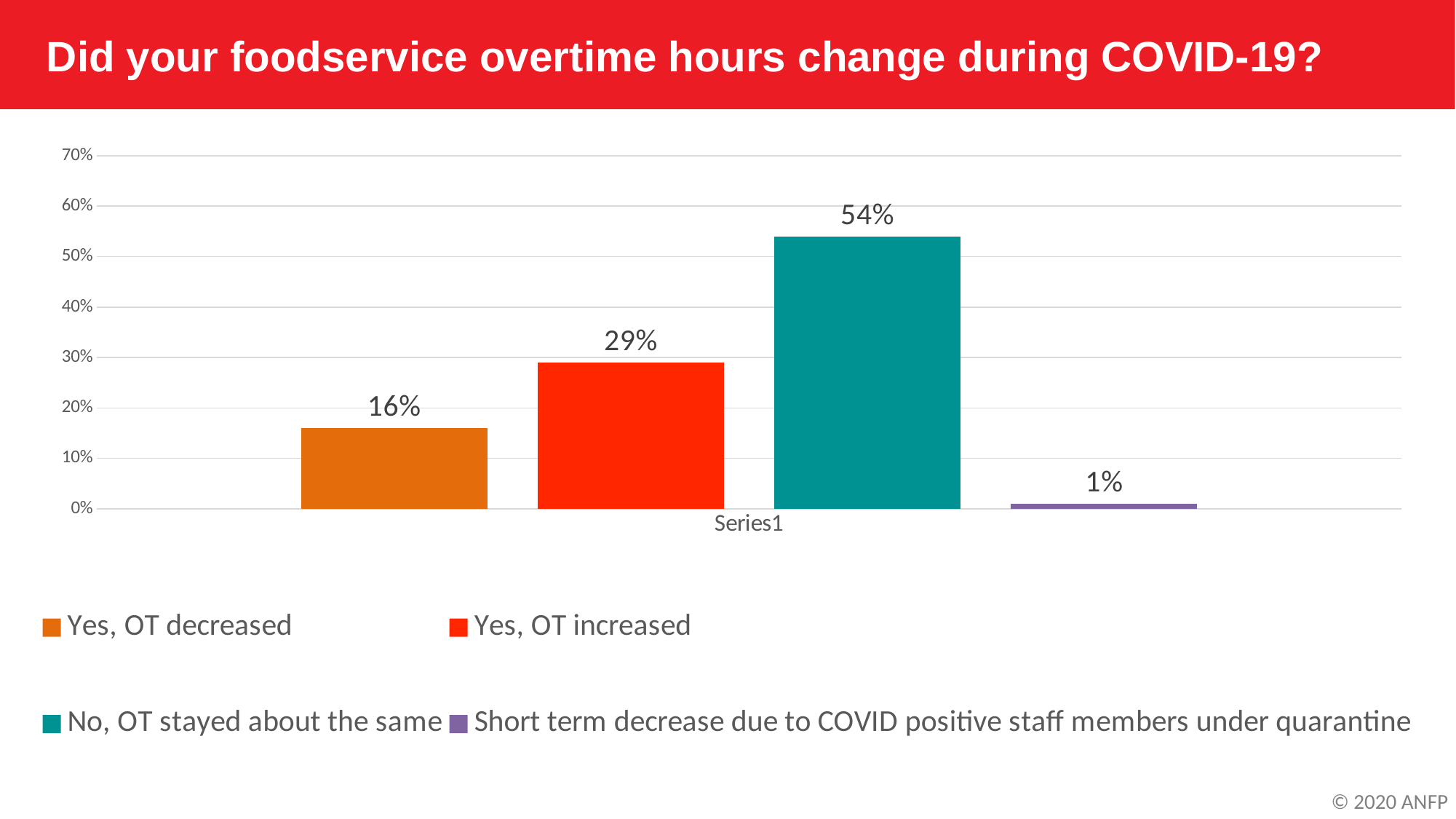
What percentage of respondents reported a short term decrease due to COVID positive staff members under quarantine? 1% Is the value for 'No, OT stayed about the same' greater or less than 50%? greater How many response categories are shown in the legend? 4 What percentage of respondents said OT stayed about the same? 54% What is the difference in percentage points between 'Yes, OT increased' and 'Yes, OT decreased'? 13 Which response has the highest percentage? No, OT stayed about the same What type of chart is shown on the slide? Bar chart What percentage of respondents said OT decreased? 16% What is the difference in percentage points between 'No, OT stayed about the same' and 'Yes, OT increased'? 25 Which response has the lowest percentage? Short term decrease due to COVID positive staff members under quarantine Which is larger: the percentage for 'Yes, OT decreased' or 'Yes, OT increased'? Yes, OT increased What percentage of respondents said OT increased? 29%